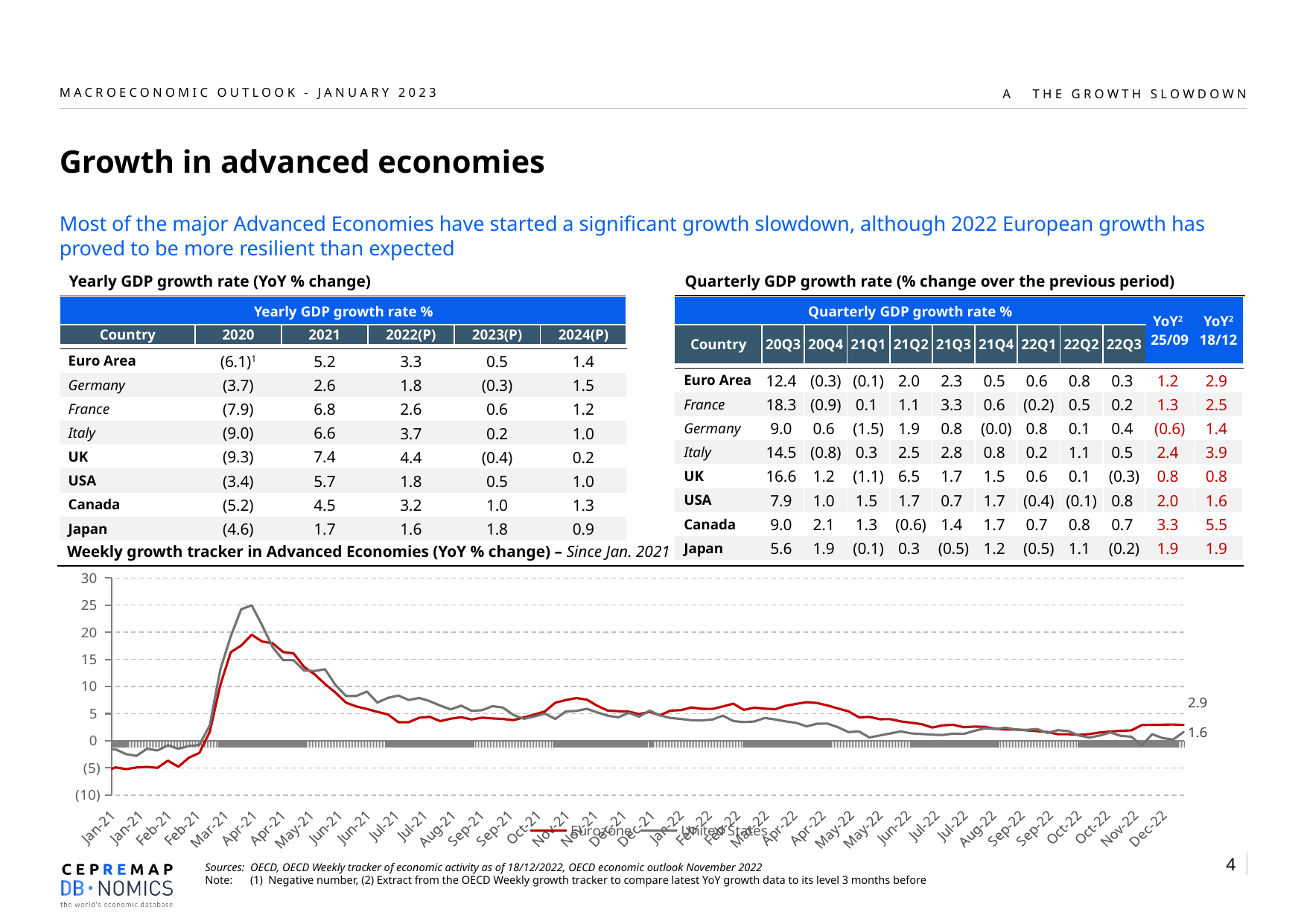
How many series does the legend of the weekly growth tracker chart list? 2 What colour is the Eurozone line in the weekly growth tracker chart? red Which two series are shown in the weekly growth tracker chart? Eurozone and United States In the weekly growth tracker chart, which series has the higher latest labelled value, Eurozone or United States? Eurozone In the weekly growth tracker chart, which series reaches the highest peak in spring 2021? United States What is the latest value labelled for the United States line in the weekly growth tracker chart? 1.6 What kind of chart is the 'Weekly growth tracker in Advanced Economies' chart? line chart What is the latest value labelled for the Eurozone line in the weekly growth tracker chart? 2.9 In the weekly growth tracker chart, is the Eurozone value in Jan-21 greater or less than 0? less In the weekly growth tracker chart, what is the difference between the latest labelled values of the Eurozone (2.9) and the United States (1.6)? 1.3 In the weekly growth tracker chart, do the values generally rise or fall from Apr-21 to Dec-22? fall In the weekly growth tracker chart, is the peak value of the United States line greater or less than 20? greater